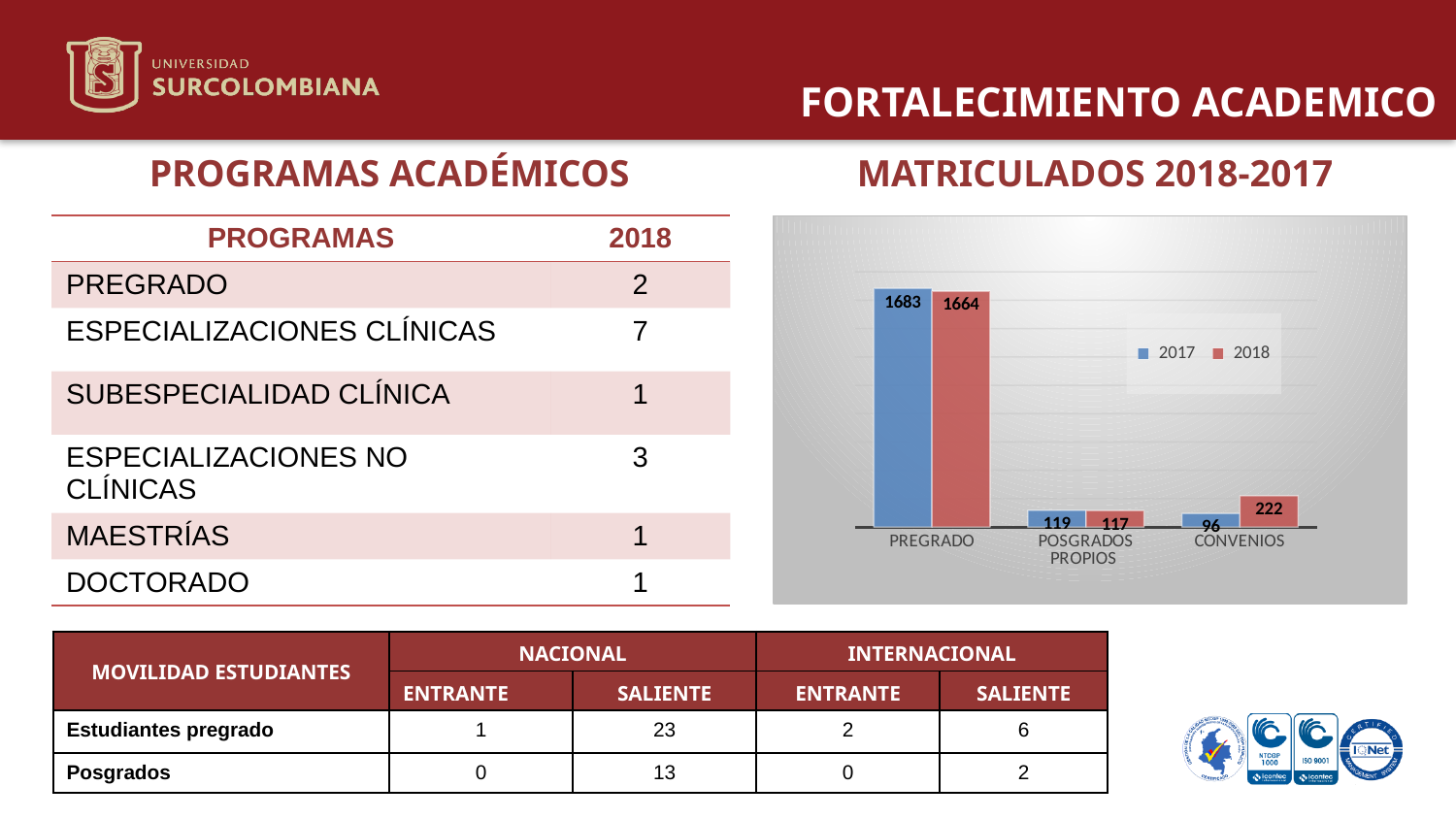
In the MATRICULADOS 2018-2017 chart, what is the 2018 value for CONVENIOS? 222 In the MATRICULADOS 2018-2017 chart, what is the 2017 value for CONVENIOS? 96 In the MATRICULADOS 2018-2017 chart, what is the difference between the 2018 and 2017 values for CONVENIOS? 126 In the MATRICULADOS 2018-2017 chart, is the 2017 or the 2018 value larger for CONVENIOS? 2018 In the MATRICULADOS 2018-2017 chart, which category has the highest 2018 value? PREGRADO How many series does the legend of the MATRICULADOS 2018-2017 chart list? 2 In the MATRICULADOS 2018-2017 chart, what is the difference between the 2017 and 2018 values for PREGRADO? 19 In the MATRICULADOS 2018-2017 chart, what is the 2017 value for POSGRADOS PROPIOS? 119 In the MATRICULADOS 2018-2017 chart, what is the 2017 value for PREGRADO? 1683 What type of chart is shown under the title MATRICULADOS 2018-2017? Bar chart In the MATRICULADOS 2018-2017 chart, which category has the lowest 2017 value? CONVENIOS In the MATRICULADOS 2018-2017 chart, what is the 2018 value for PREGRADO? 1664